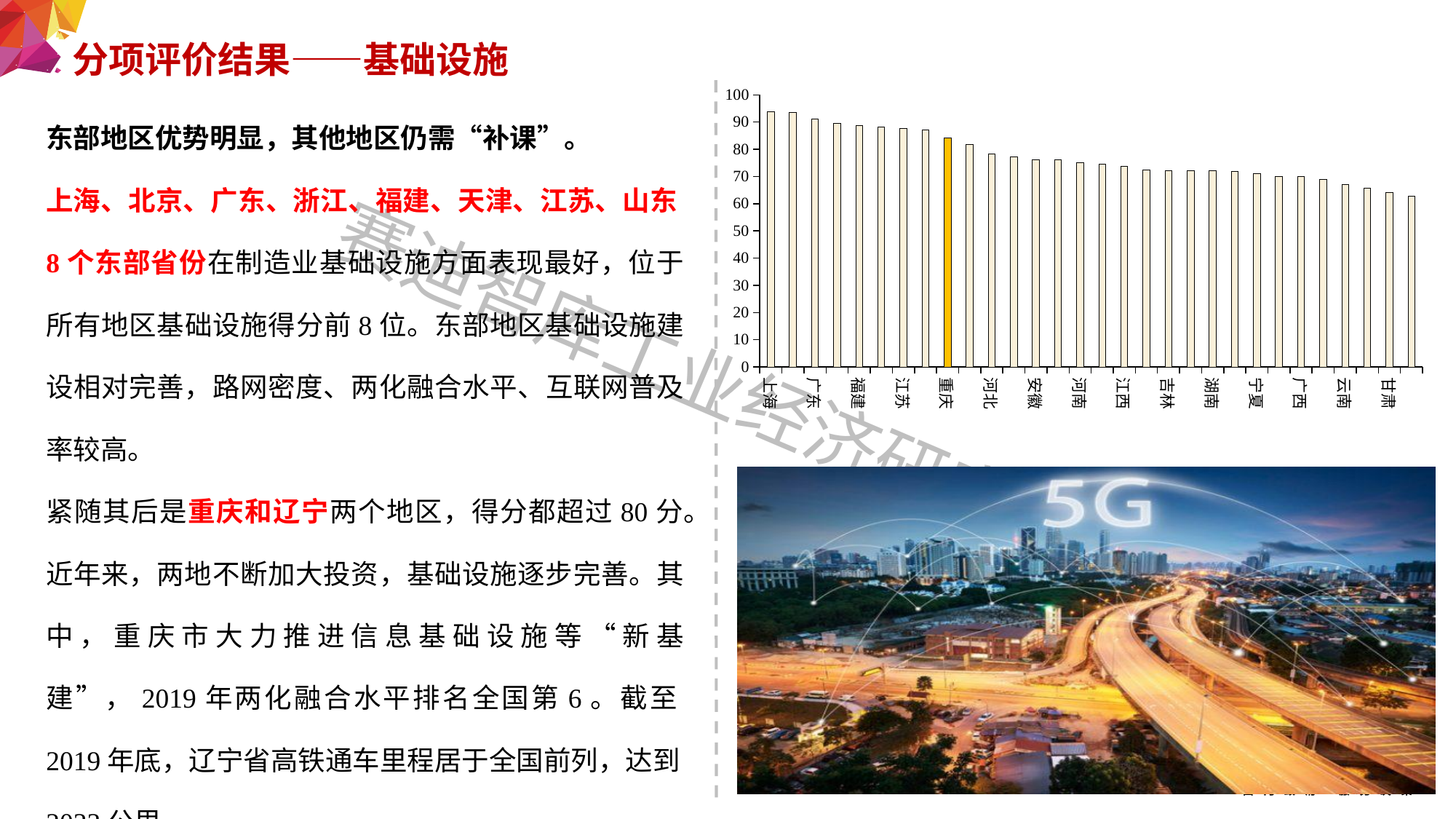
Is the value for 重庆 greater or less than 80? greater Which has the larger value, 上海 or 甘肃? 上海 Is the value for 安徽 greater or less than 80? less Is the value for 甘肃 greater or less than 70? less Which has the larger value, 重庆 or 河北? 重庆 What kind of chart is shown on the slide? bar chart Which category's bar is highlighted in orange? 重庆 What is the highest value shown on the y axis? 100 Do the bar values rise or fall from left to right along the x axis? fall